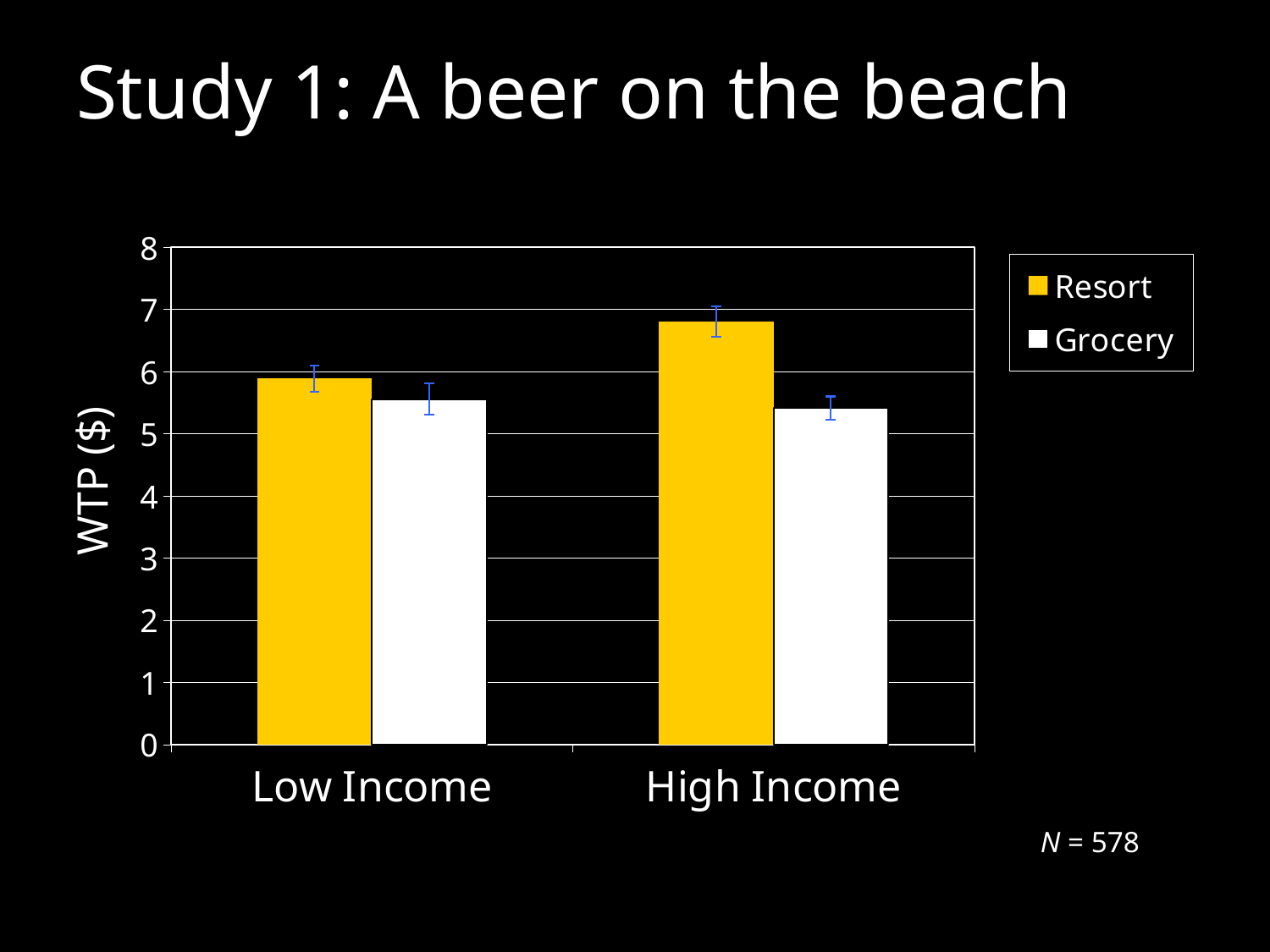
How many income categories are shown on the x axis? 2 For High Income, which is larger: Resort or Grocery? Resort Is the Resort value for High Income greater or less than 6? greater Which bar is the highest in the chart? Resort, High Income Is the Resort value for High Income greater or less than 7? less Is the Grocery value for Low Income greater or less than 5? greater Which colour represents the Resort series in the legend? yellow What is the label on the y axis? WTP ($) Does the Resort value rise or fall from Low Income to High Income? rise How many series does the legend list? 2 What kind of chart is shown on the slide? bar chart